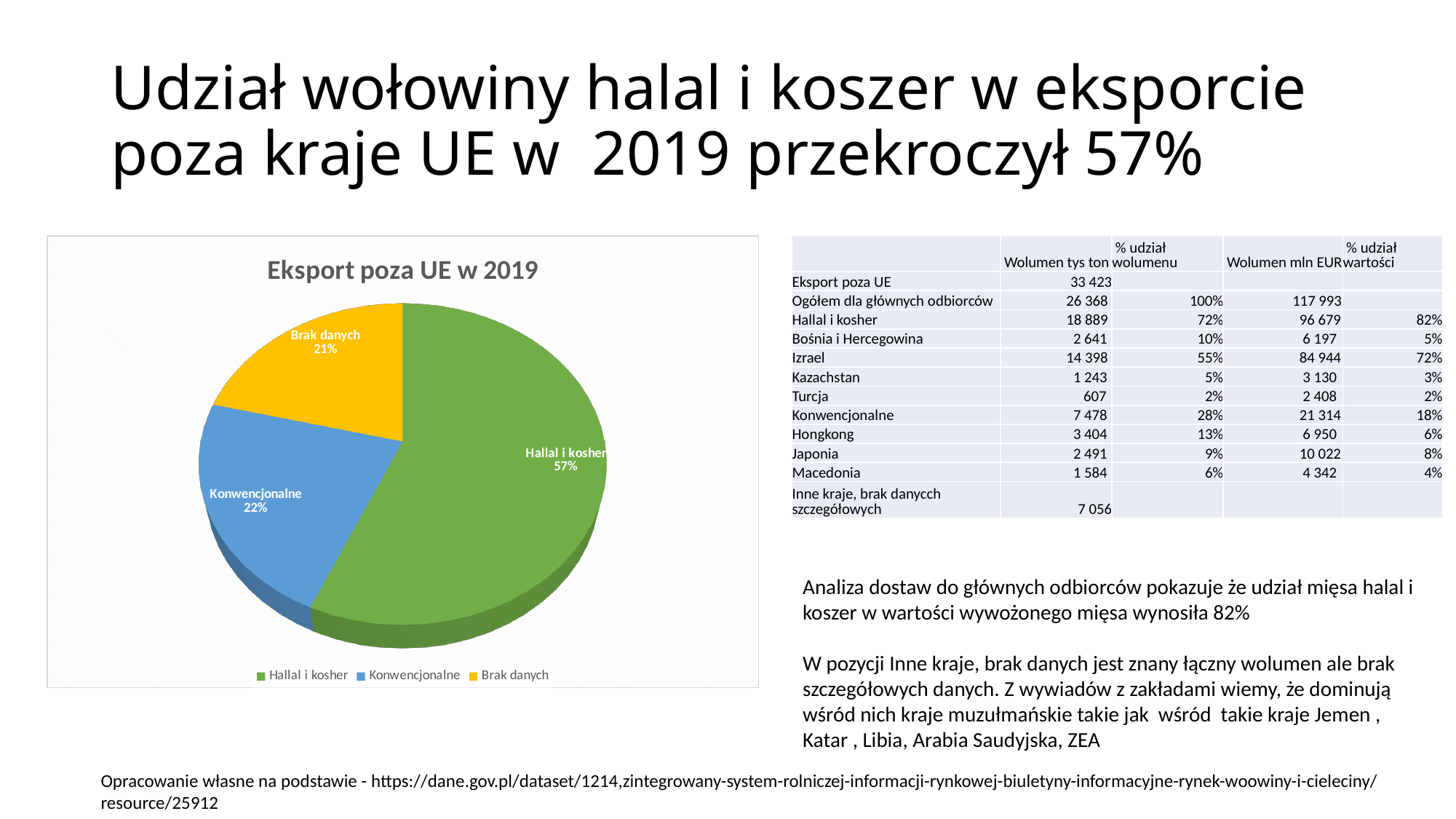
What share of the pie does Hallal i kosher have? 57% How many entries does the pie chart legend list? 3 Which slice of the pie chart is the largest? Hallal i kosher What type of chart is shown on the left of the slide? pie chart What share of the pie does Brak danych have? 21% What share of the pie does Konwencjonalne have? 22% What is the title of the pie chart? Eksport poza UE w 2019 What is the difference in percentage points between the Hallal i kosher slice and the Konwencjonalne slice? 35 What colour is the Hallal i kosher slice in the pie chart? green How many slices does the pie chart have? 3 Which is larger in the pie chart, Hallal i kosher or Brak danych? Hallal i kosher Which slice of the pie chart is the smallest? Brak danych